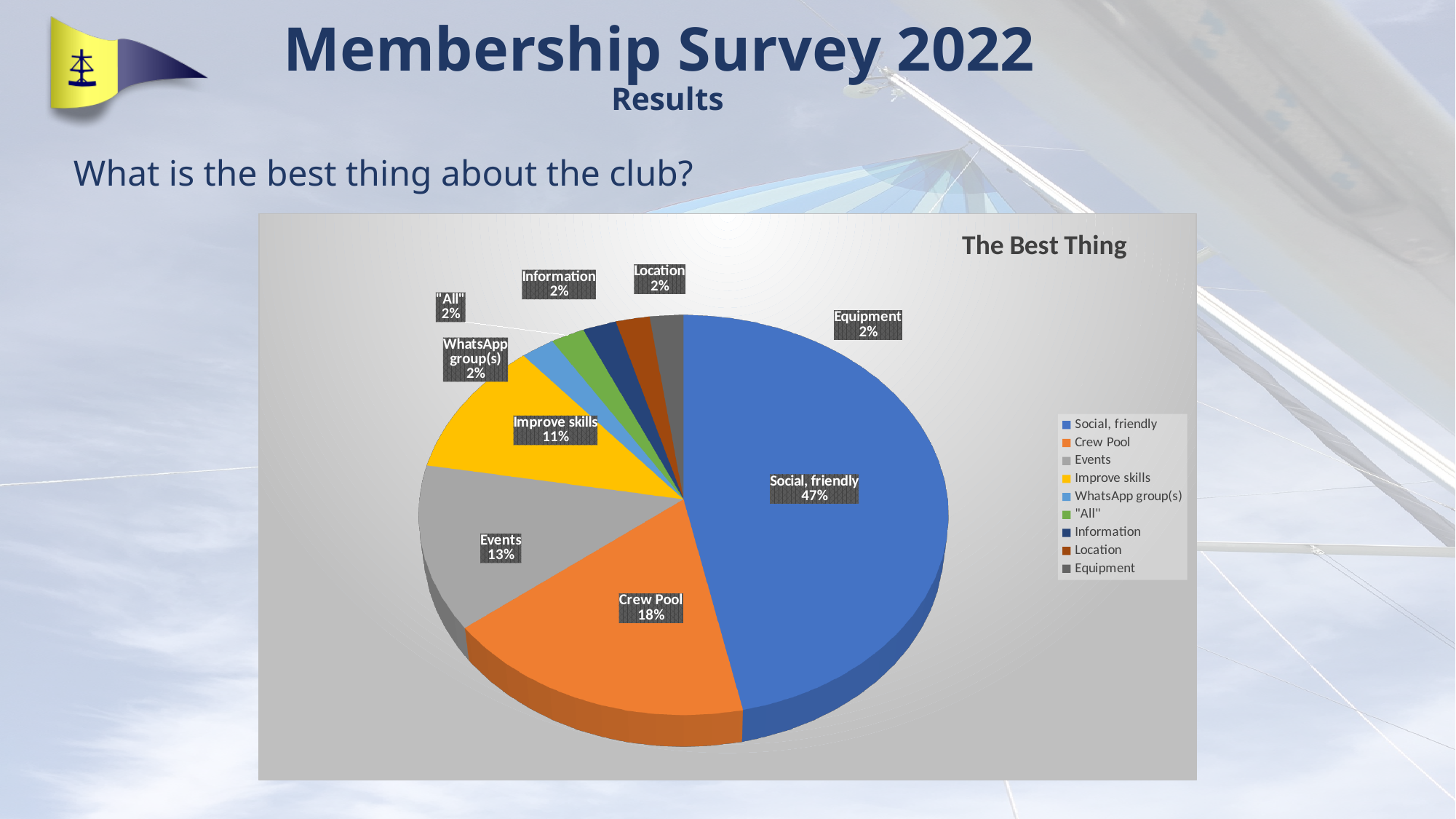
How many categories are shown in the pie chart? 9 Which category has the largest slice of the pie? Social, friendly What is the difference between the Crew Pool and Events values? 5% What share of the pie does Social, friendly have? 47% What kind of chart is shown on the slide? Pie chart What is the value shown for Crew Pool? 18% What colour is the Improve skills slice? Yellow What is the title of the chart? The Best Thing What is the value shown for Improve skills? 11% What is the value shown for Events? 13% Which is larger, Events or Improve skills? Events What is the value shown for WhatsApp group(s)? 2%